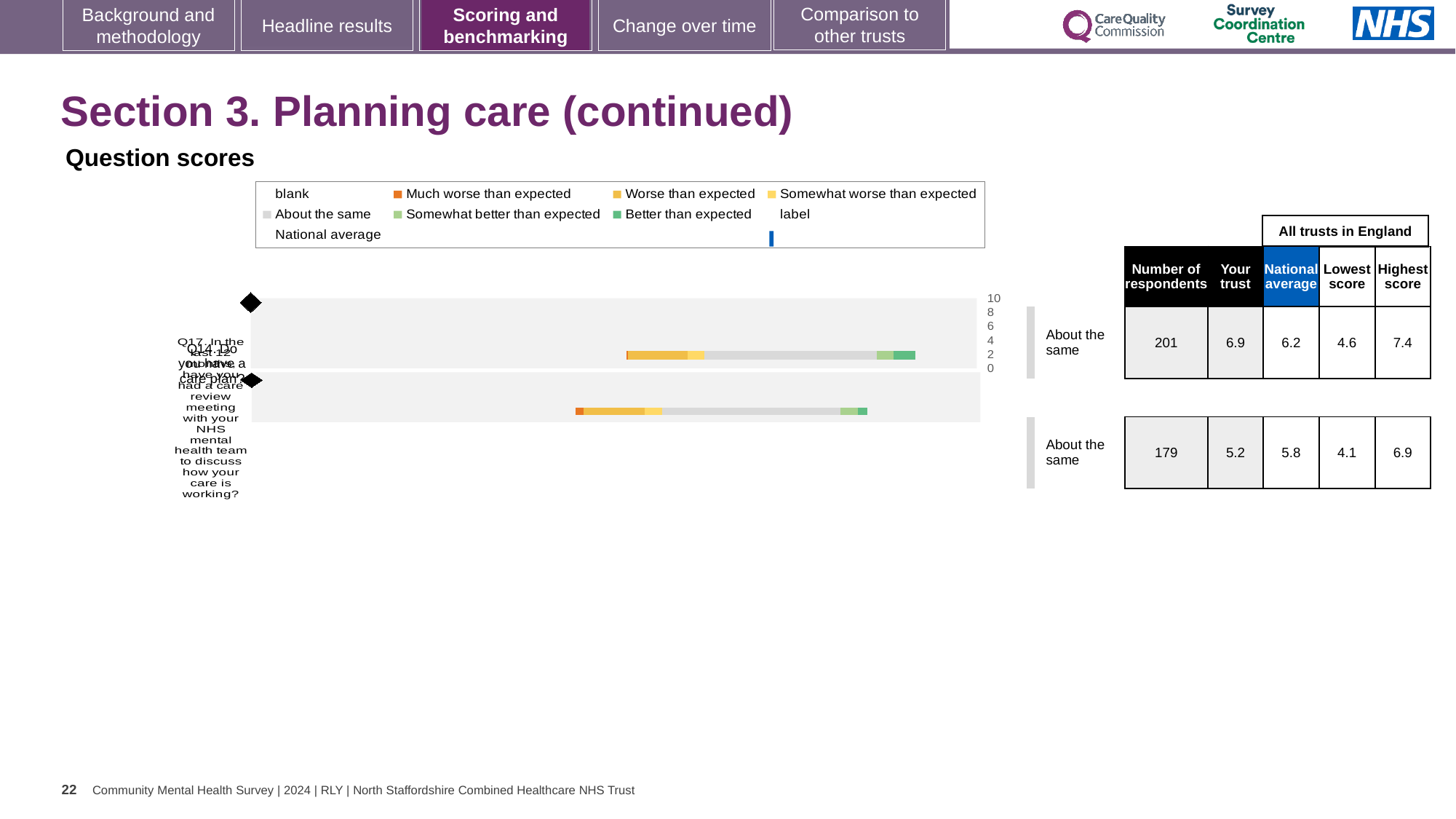
In the table, what is the national average for the bottom row? 5.8 In the table, what is the highest score for the bottom row? 6.9 For the bottom row, what is the difference between the national average and the 'Your trust' score? 0.6 In the table, what is the number of respondents for the top row? 201 In the table, what is the 'Your trust' score for the top row? 6.9 What kind of chart is shown on the slide? bar chart How many question bars are plotted in the chart? 2 What is the highest value shown on the chart's axis? 10 For the top row, which is larger: the 'Your trust' score or the national average? Your trust For the top row, what is the difference between the highest score and the lowest score? 2.8 What colour does the legend use for 'Better than expected'? green In the table, what is the lowest score for the top row? 4.6